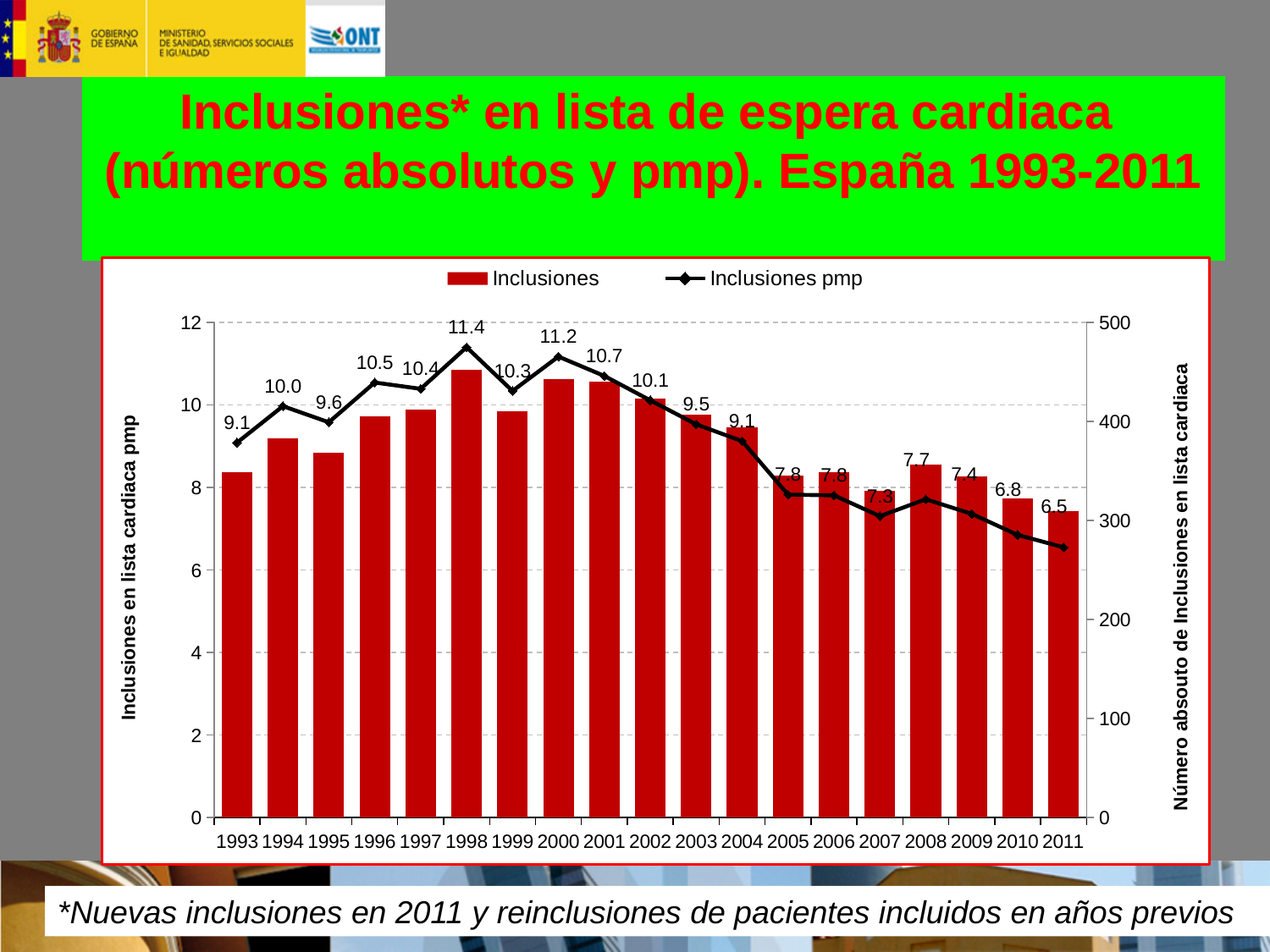
Is the Inclusiones bar for 1993 greater or less than 400 on the right axis? less Is the Inclusiones bar for 1998 greater or less than 400 on the right axis? greater How many years are shown on the x axis? 19 How many series does the legend list? 2 In which year is Inclusiones pmp lowest? 2011 What is the value of Inclusiones pmp for 2005? 7.8 What is the value of Inclusiones pmp for 1998? 11.4 What is the difference between Inclusiones pmp in 1998 and in 2011? 4.9 Which year has the higher Inclusiones pmp, 2000 or 2001? 2000 In which year is Inclusiones pmp highest? 1998 What is the value of Inclusiones pmp for 2011? 6.5 What kind of chart is shown on the slide? Combined bar and line chart